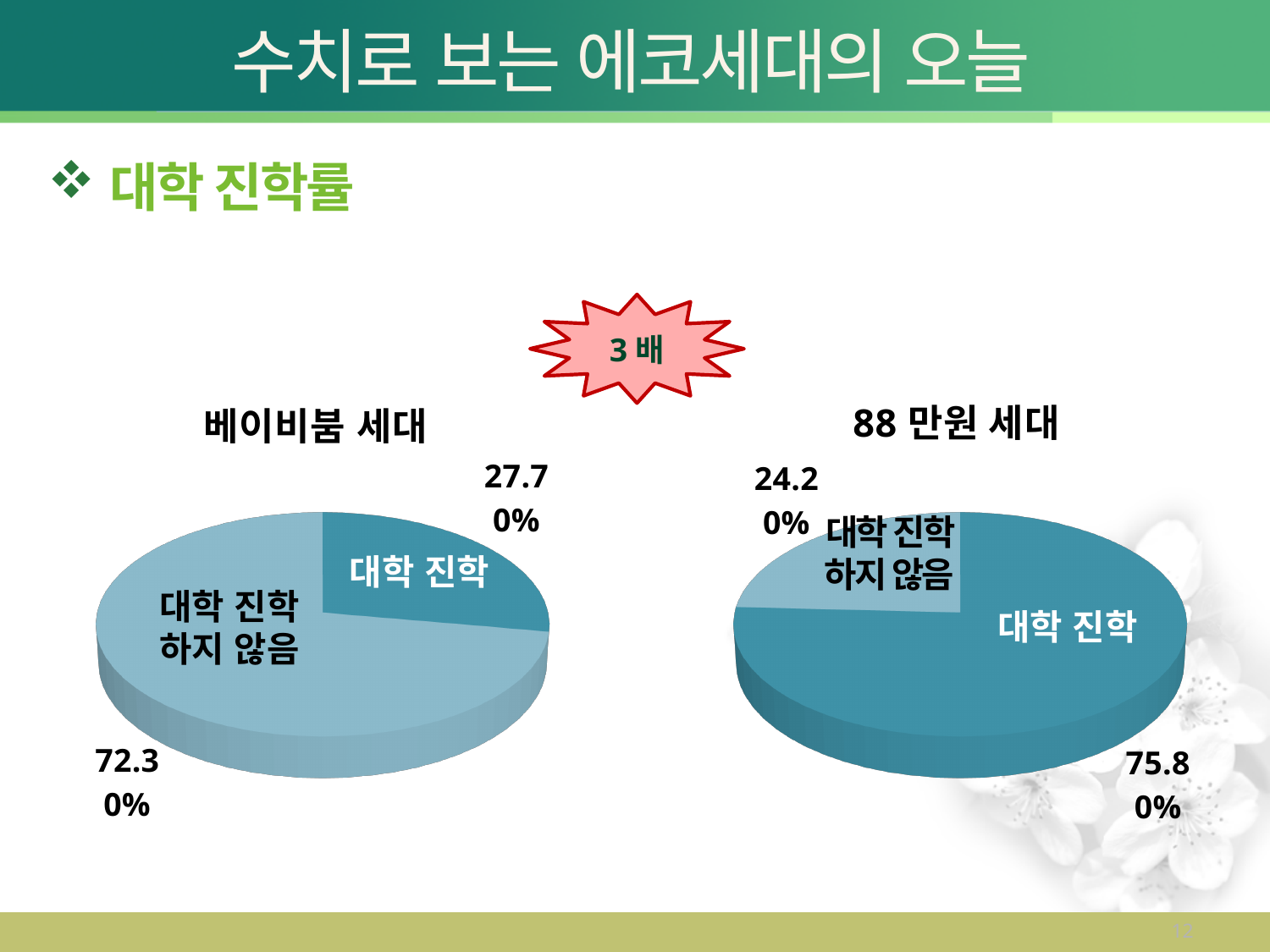
What kind of chart is used for the 베이비붐 세대 data? pie chart What text is shown in the starburst shape between the two charts? 3 배 In the 88 만원 세대 chart, which is larger: 대학 진학 or 대학 진학 하지 않음? 대학 진학 In the 88 만원 세대 chart, what is the value for 대학 진학 하지 않음? 24.20% In the 베이비붐 세대 chart, what is the value for 대학 진학 하지 않음? 72.30% What is the difference between the 대학 진학 value in the 88 만원 세대 chart and the 대학 진학 value in the 베이비붐 세대 chart? 48.10 percentage points What is the title of the pie chart on the right side of the slide? 88 만원 세대 In the 88 만원 세대 chart, which slice is the smallest? 대학 진학 하지 않음 In the 베이비붐 세대 chart, which slice is the largest? 대학 진학 하지 않음 How many slices does the 베이비붐 세대 pie chart have? 2 In the 베이비붐 세대 chart, what is the value for 대학 진학? 27.70% In the 88 만원 세대 chart, what is the value for 대학 진학? 75.80%